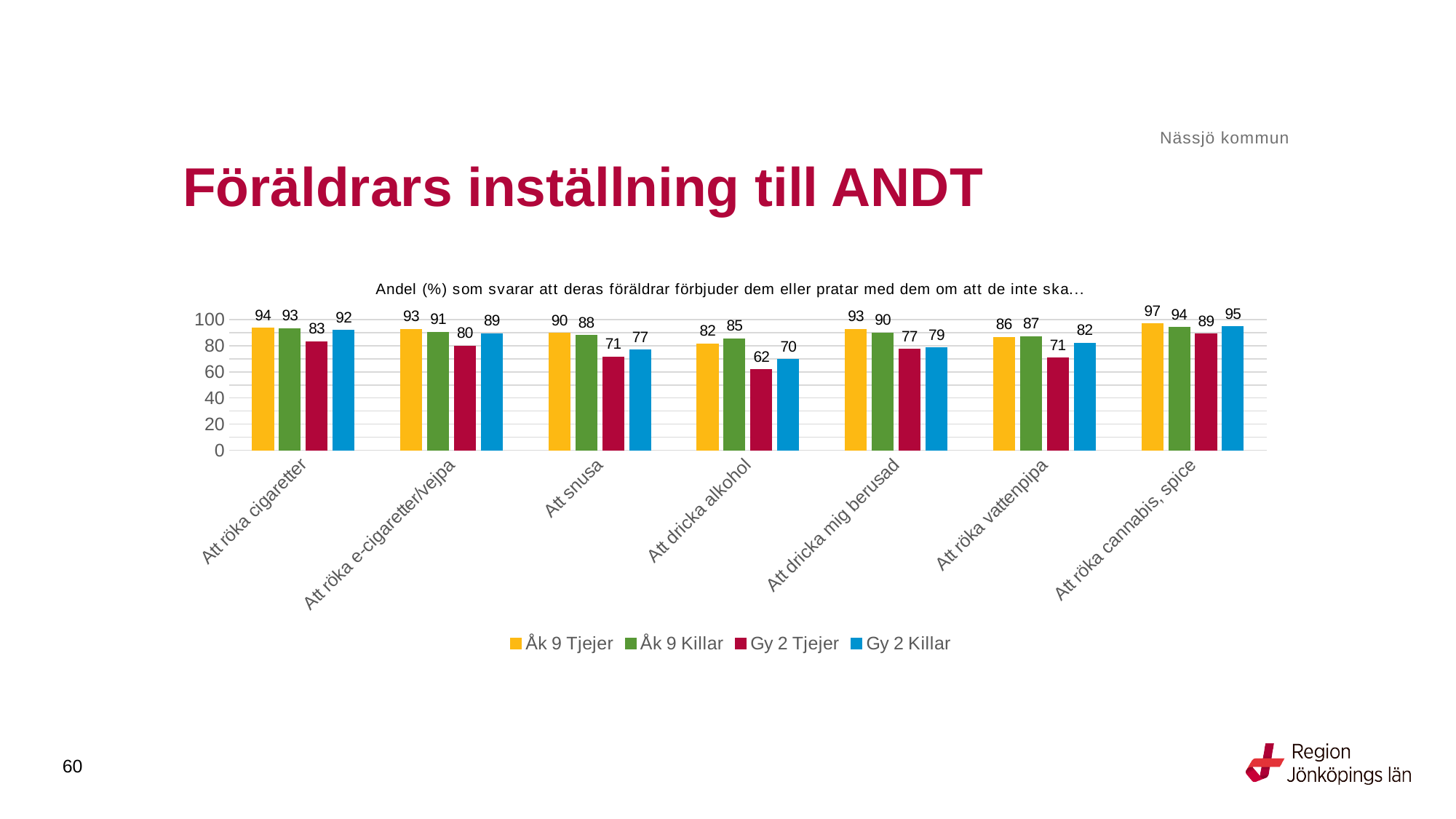
Which category has the lowest value for Gy 2 Tjejer? Att dricka alkohol What kind of chart is shown on the slide? Bar chart What is the value for Gy 2 Tjejer for "Att dricka alkohol"? 62 Which is larger for "Att röka vattenpipa": Åk 9 Tjejer or Gy 2 Killar? Åk 9 Tjejer What is the difference between Åk 9 Killar and Gy 2 Tjejer for "Att dricka alkohol"? 23 What is the difference between Gy 2 Killar and Gy 2 Tjejer for "Att röka vattenpipa"? 11 What is the value for Gy 2 Killar for "Att snusa"? 77 How many categories are shown on the x axis? 7 How many series does the legend list? 4 Which series is shown in blue in the legend? Gy 2 Killar Which category has the highest value for Åk 9 Tjejer? Att röka cannabis, spice What is the value for Åk 9 Tjejer for "Att röka cannabis, spice"? 97